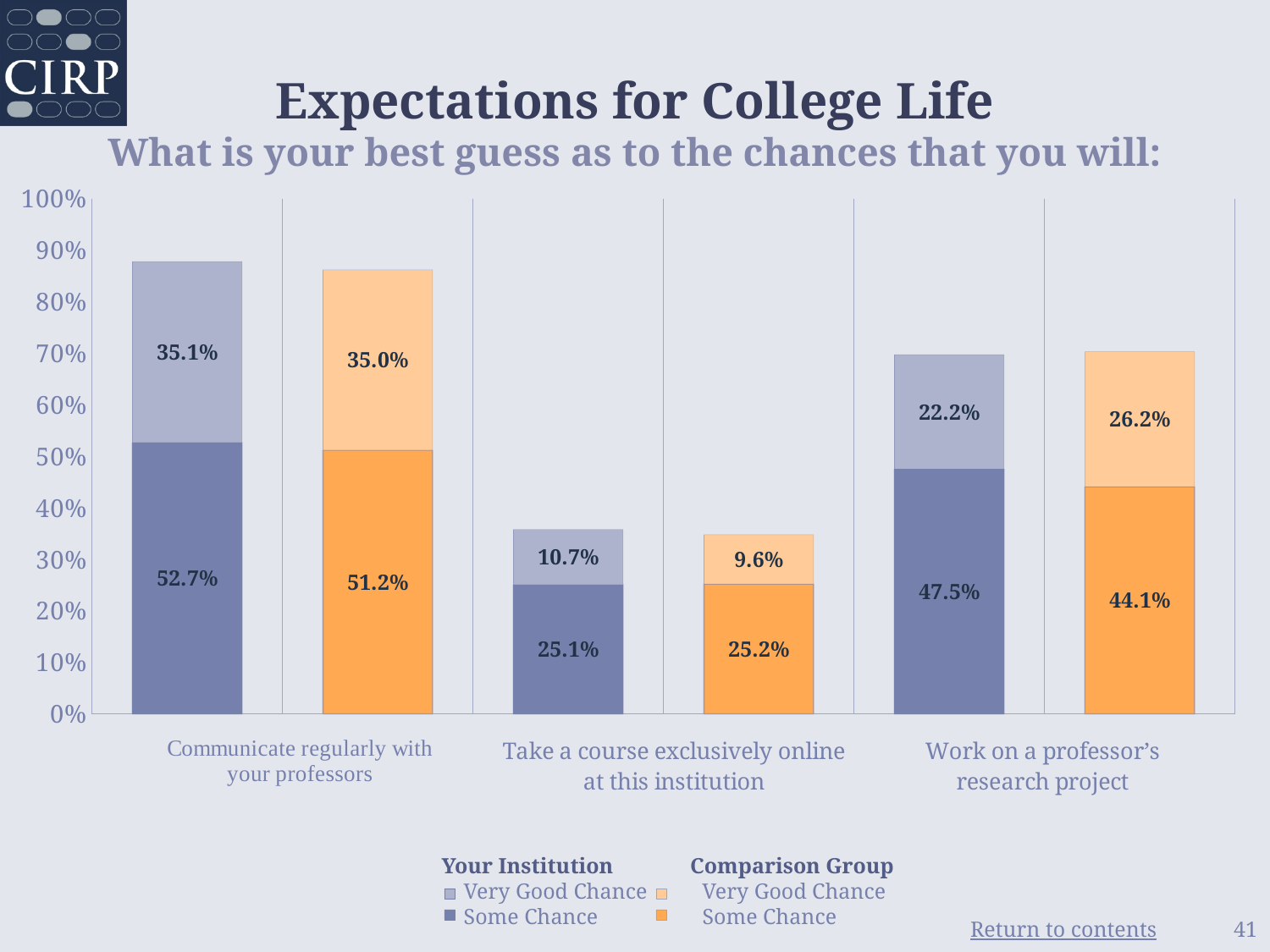
What is the total of the Comparison Group stacked bar for taking a course exclusively online at this institution? 34.8% How many series does the legend list? 4 Which category has the highest Some Chance value for the Comparison Group? Communicate regularly with your professors What kind of chart is shown on the slide? Stacked bar chart How many categories are shown on the x axis of the chart? 3 What is the difference between Your Institution's Some Chance value and its Very Good Chance value for working on a professor's research project? 25.3% For working on a professor's research project, which is larger: Your Institution's Very Good Chance value or the Comparison Group's Very Good Chance value? Comparison Group's Very Good Chance value What is the Comparison Group's Some Chance value for taking a course exclusively online at this institution? 25.2% Which category has the lowest Very Good Chance value for Your Institution? Take a course exclusively online at this institution What percentage of Your Institution students said there is a Very Good Chance they will communicate regularly with their professors? 35.1% What is the Comparison Group's Very Good Chance value for working on a professor's research project? 26.2% What is the total of the Your Institution stacked bar for communicating regularly with your professors? 87.8%